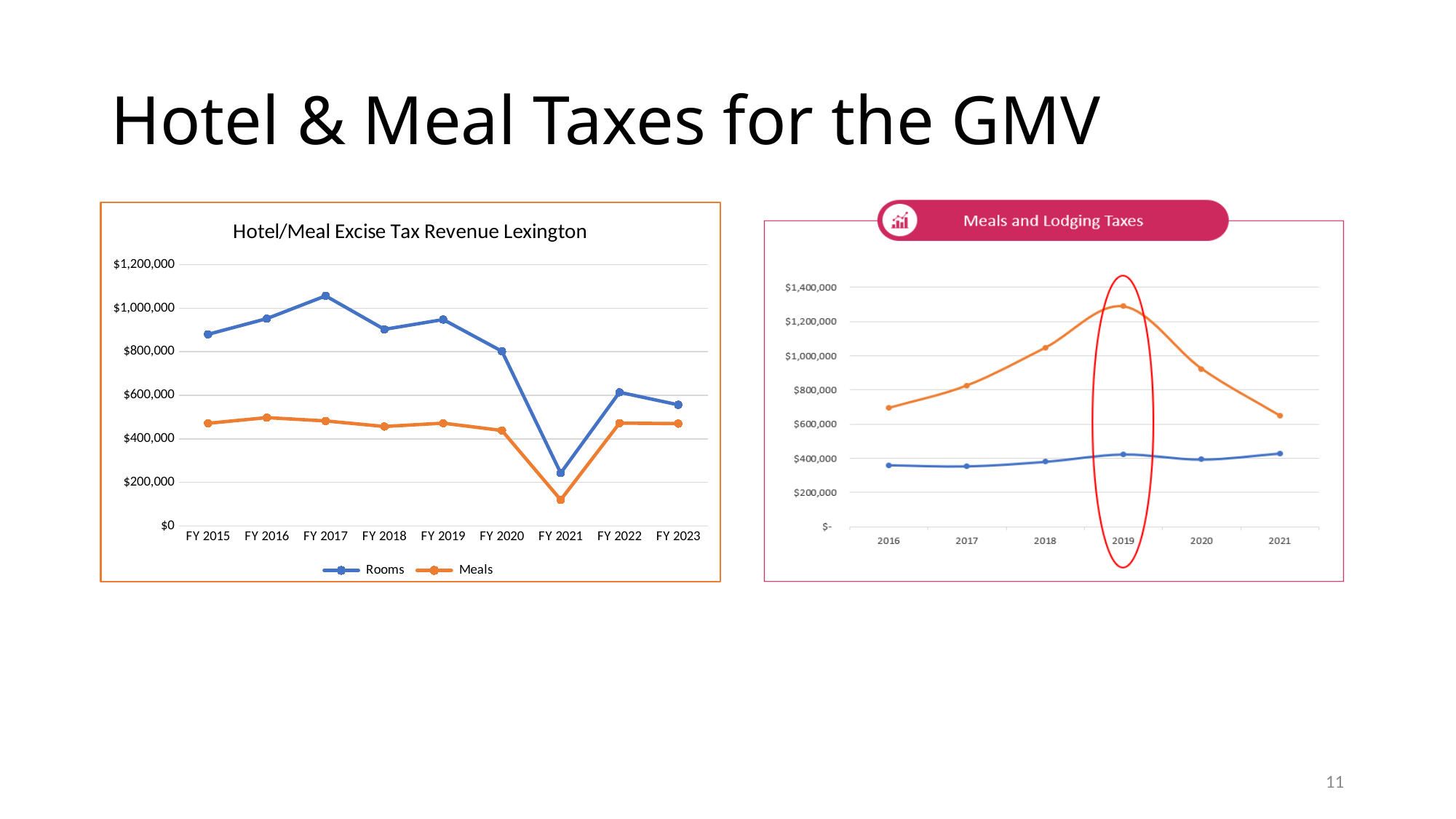
In the 'Hotel/Meal Excise Tax Revenue Lexington' chart, in which fiscal year is the Rooms value highest? FY 2017 How many series does the legend of the 'Hotel/Meal Excise Tax Revenue Lexington' chart list? 2 What kind of chart is the 'Hotel/Meal Excise Tax Revenue Lexington' chart? Line chart How many years are plotted on the x axis of the 'Meals and Lodging Taxes' chart? 6 In the 'Hotel/Meal Excise Tax Revenue Lexington' chart, in which fiscal year is the Meals value lowest? FY 2021 In the 'Hotel/Meal Excise Tax Revenue Lexington' chart, in which fiscal year is the Rooms value lowest? FY 2021 In the 'Hotel/Meal Excise Tax Revenue Lexington' chart, is the Rooms value for FY 2017 greater or less than $1,000,000? greater In the 'Hotel/Meal Excise Tax Revenue Lexington' chart, is the Meals value for FY 2021 greater or less than $200,000? less In the 'Meals and Lodging Taxes' chart, in which year does the orange line reach its highest value? 2019 How many fiscal years are plotted on the x axis of the 'Hotel/Meal Excise Tax Revenue Lexington' chart? 9 In the 'Hotel/Meal Excise Tax Revenue Lexington' chart, which series has the larger value in FY 2019, Rooms or Meals? Rooms In the 'Meals and Lodging Taxes' chart, is the orange line's value for 2019 greater or less than $1,200,000? greater